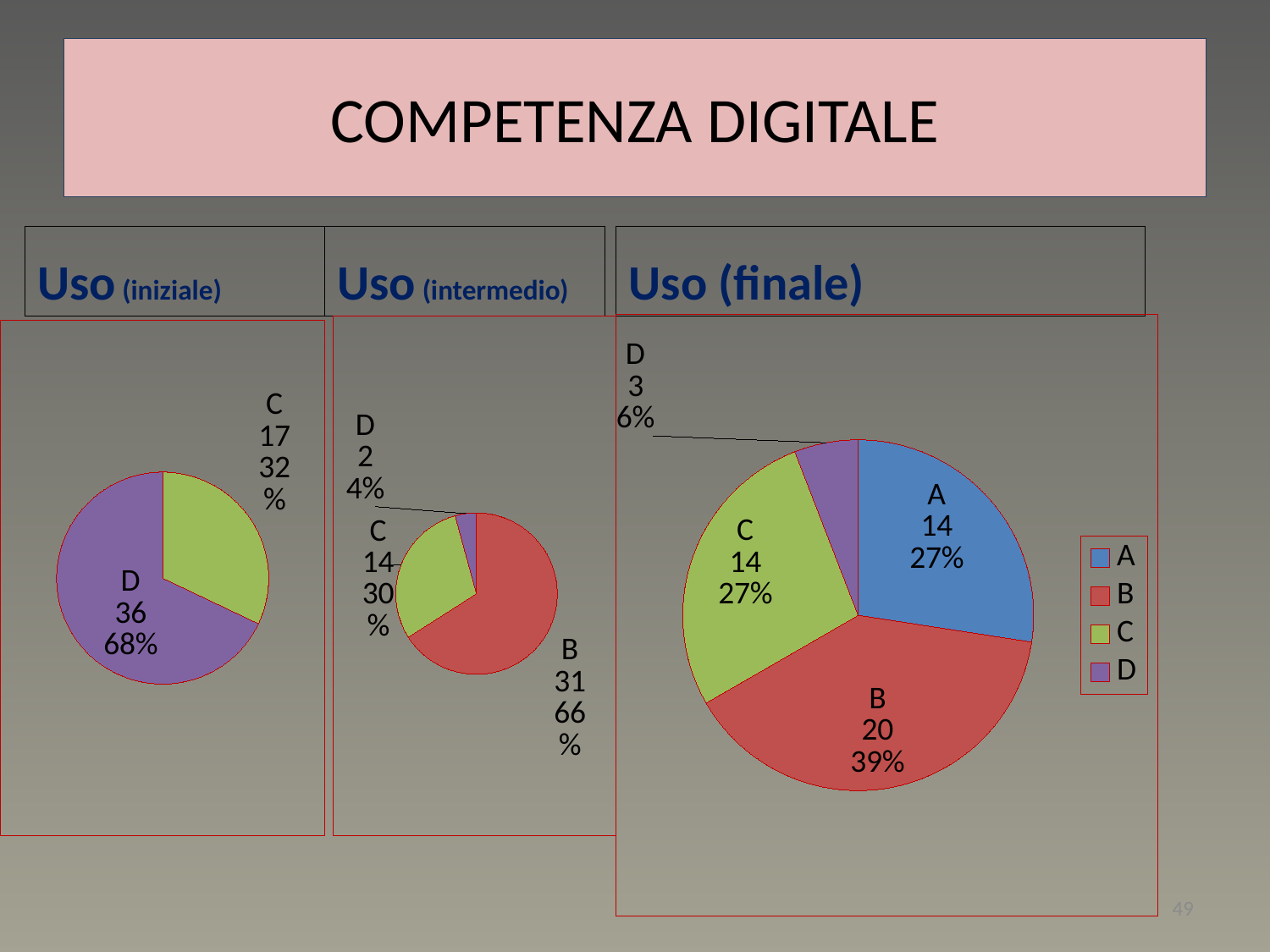
In the Uso (iniziale) pie chart, what share of the pie does C represent? 32% What kind of chart is used for Uso (finale)? Pie chart In the Uso (finale) pie chart, what is the value for B? 20 In the Uso (intermedio) pie chart, what is the difference between the values for B and C? 17 In the Uso (intermedio) pie chart, what share of the pie does C represent? 30% In the Uso (iniziale) pie chart, what is the value for D? 36 In the Uso (finale) pie chart, how many entries does the legend list? 4 In the Uso (intermedio) pie chart, what is the value for B? 31 In the Uso (intermedio) pie chart, which category has the smallest slice? D In the Uso (iniziale) pie chart, how many slices are there? 2 In the Uso (finale) pie chart, what share of the pie does D represent? 6% In the Uso (finale) pie chart, which category has the largest slice? B